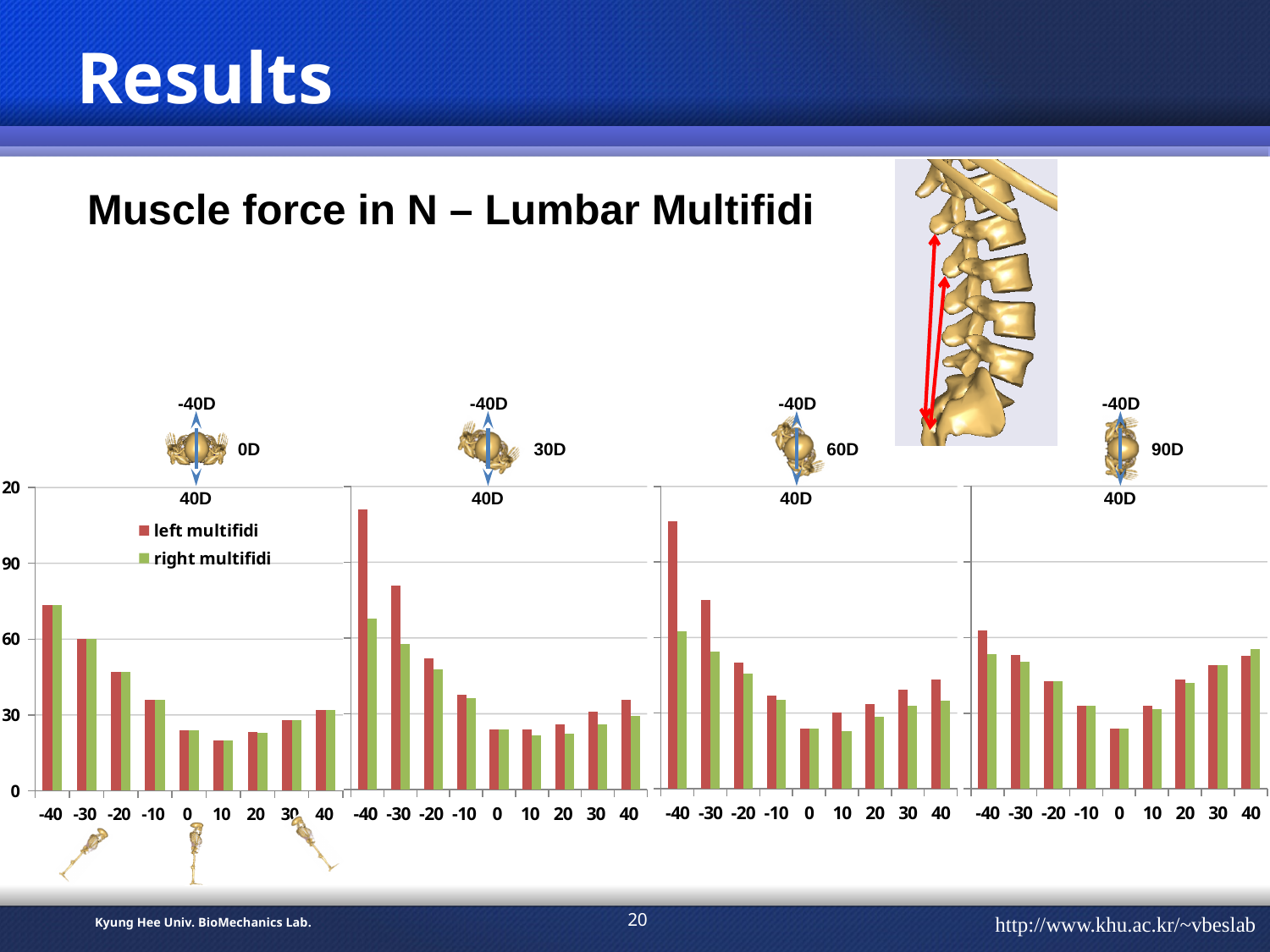
In the 0D chart, is the left multifidi value at -40 greater or less than 60? greater In the 0D chart, which x-axis category has the lowest left multifidi value? 10 In the 30D chart, is the left multifidi value at -40 greater or less than 90? greater What kind of chart is used for the 0D panel? bar chart In the 90D chart, is the left multifidi value at 0 greater or less than 30? less In the 30D chart, at -40, which is larger: left multifidi or right multifidi? left multifidi Which colour represents right multifidi in the legend? green In the 30D chart, do the left multifidi values rise or fall from -40 to 0 along the x axis? fall In the 0D chart, which x-axis category has the highest left multifidi value? -40 How many series does the legend on the 0D chart list? 2 How many categories are shown on the x axis of the 30D chart? 9